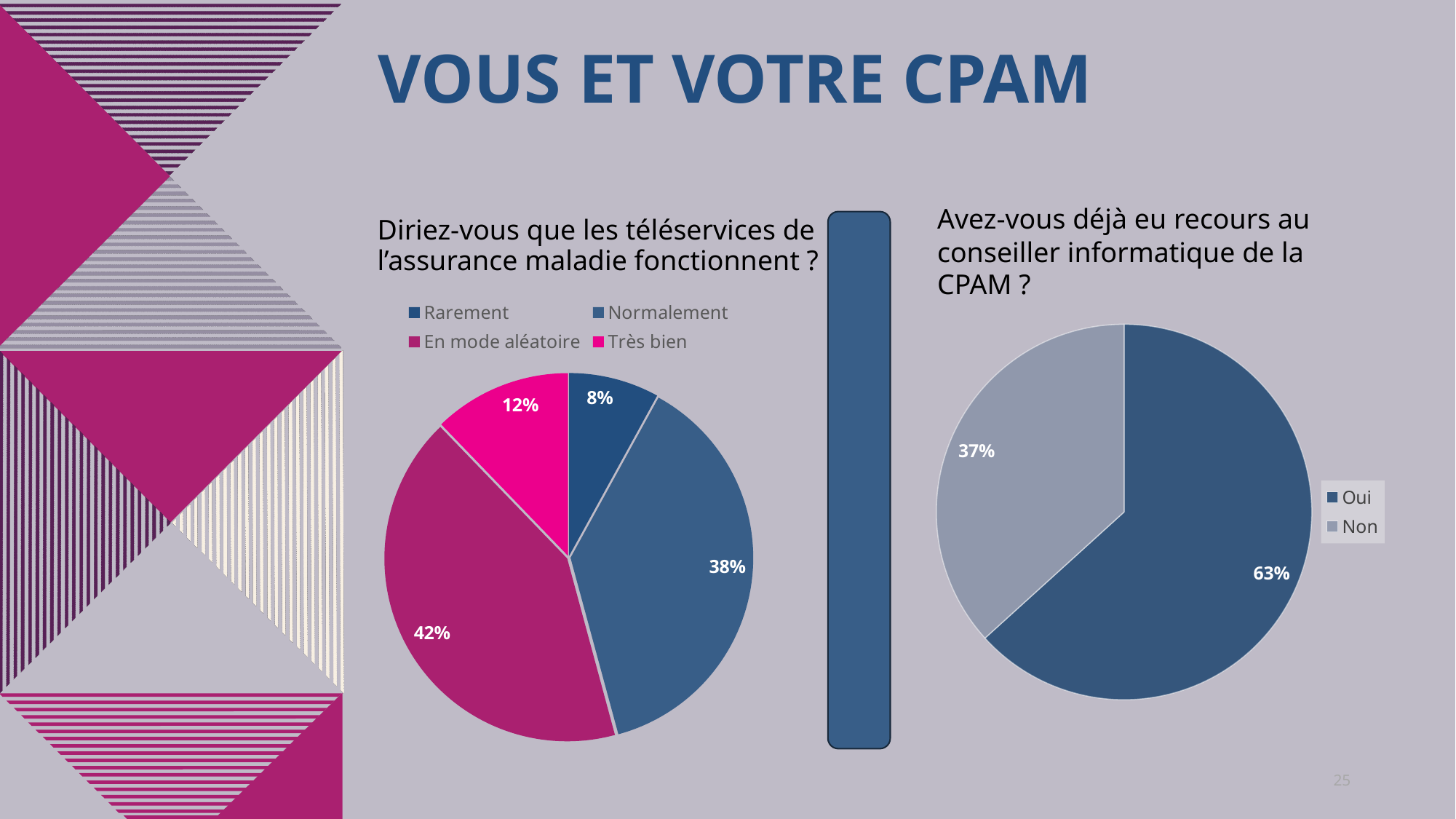
In the left pie chart, which category has the largest slice? En mode aléatoire In the left pie chart, how many categories does the legend list? 4 In the right pie chart, what is the difference between the 'Oui' and 'Non' shares? 26% In the left pie chart, what is the difference between the 'Normalement' and 'Très bien' shares? 26% In the left pie chart, what share is labelled for 'Rarement'? 8% In the right pie chart (Avez-vous déjà eu recours au conseiller informatique de la CPAM ?), what share is labelled for 'Oui'? 63% In the left pie chart, which category has the smallest slice? Rarement In the left pie chart, what share is labelled for 'Normalement'? 38% What kind of chart is used on the right side of the slide? Pie chart In the right pie chart, what share is labelled for 'Non'? 37% In the right pie chart, which is larger, 'Oui' or 'Non'? Oui In the left pie chart (Diriez-vous que les téléservices de l'assurance maladie fonctionnent ?), what share is labelled for 'En mode aléatoire'? 42%